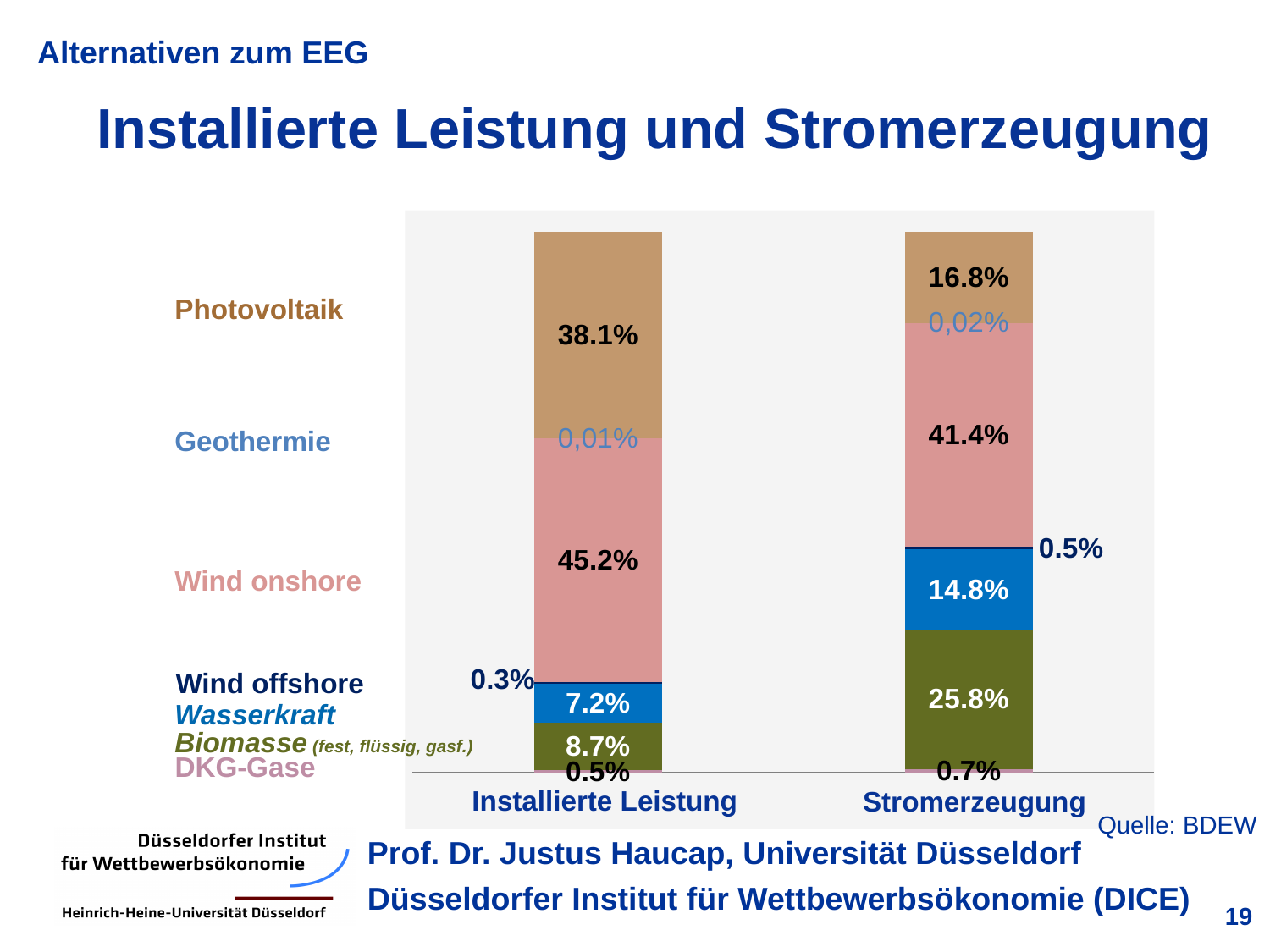
Which series has the smallest share in the Stromerzeugung bar? Geothermie How much larger is the Photovoltaik share in Installierte Leistung than in Stromerzeugung? 21.3 percentage points What share does Wind onshore have in the Stromerzeugung bar? 41.4% How many bars are shown in the chart? 2 What is the value for Wasserkraft in the Installierte Leistung bar? 7.2% What is the value for Geothermie in the Stromerzeugung bar? 0,02% How many series does the legend list? 7 Is the Biomasse share larger in Installierte Leistung or in Stromerzeugung? Stromerzeugung Which series has the largest share in the Installierte Leistung bar? Wind onshore What is the value for Biomasse in the Stromerzeugung bar? 25.8% What share does Photovoltaik have in the Installierte Leistung bar? 38.1% What kind of chart is shown on the slide? Stacked bar chart